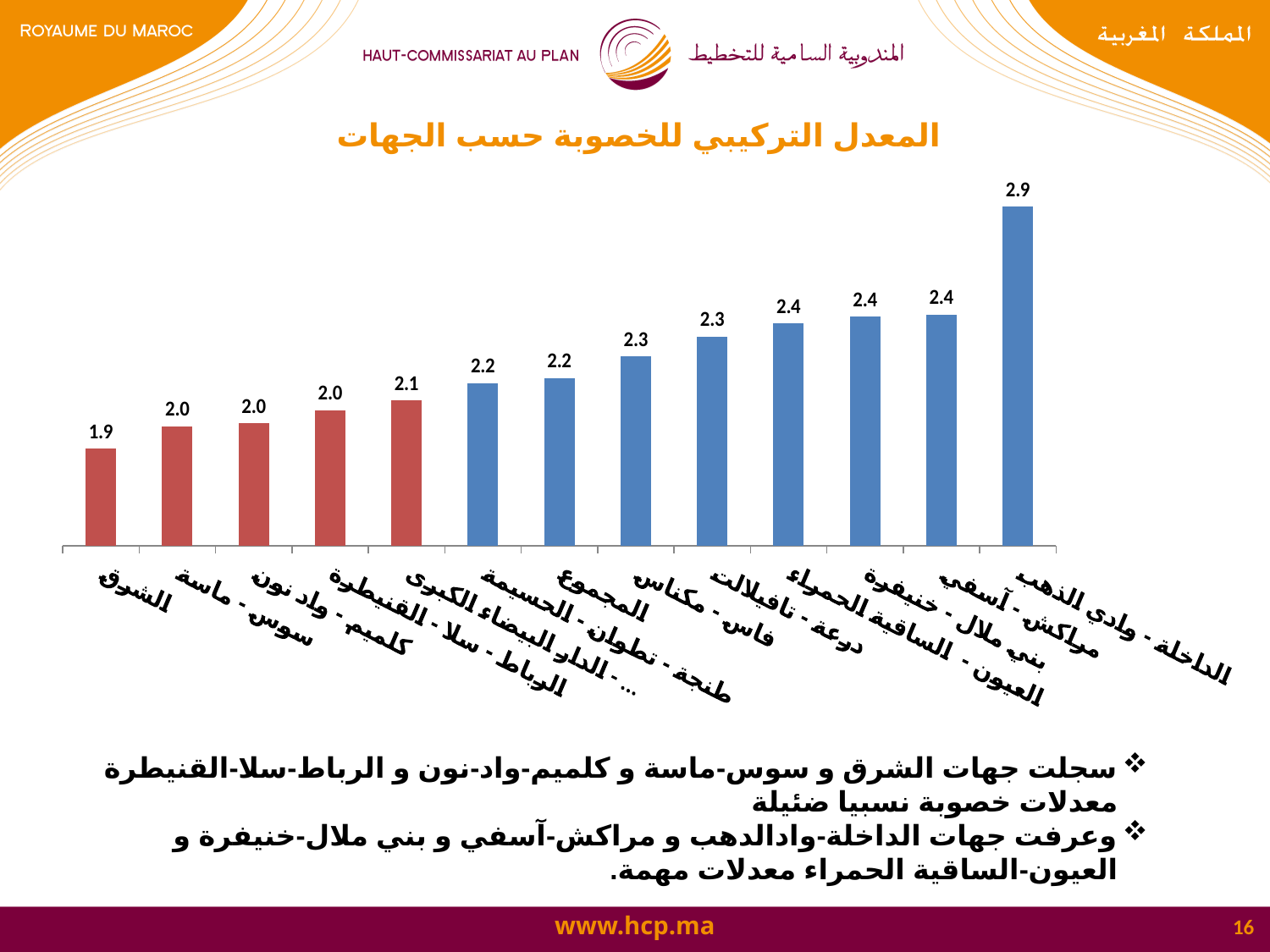
Which is larger, the value for مراكش - آسفي or the value for سوس - ماسة? مراكش - آسفي What is the value for الداخلة - وادي الذهب? 2.9 Which region has the highest value? الداخلة - وادي الذهب What is the title of the chart? المعدل التركيبي للخصوبة حسب الجهات Which region has the lowest value? الشرق What is the difference between the values for الداخلة - وادي الذهب and الشرق? 1.0 What is the value for المجموع? 2.2 How many bars are shown in the chart? 13 What is the value for فاس - مكناس? 2.3 What type of chart is shown on the slide? bar chart What is the value for الرباط - سلا - القنيطرة? 2.0 What is the value for الشرق? 1.9